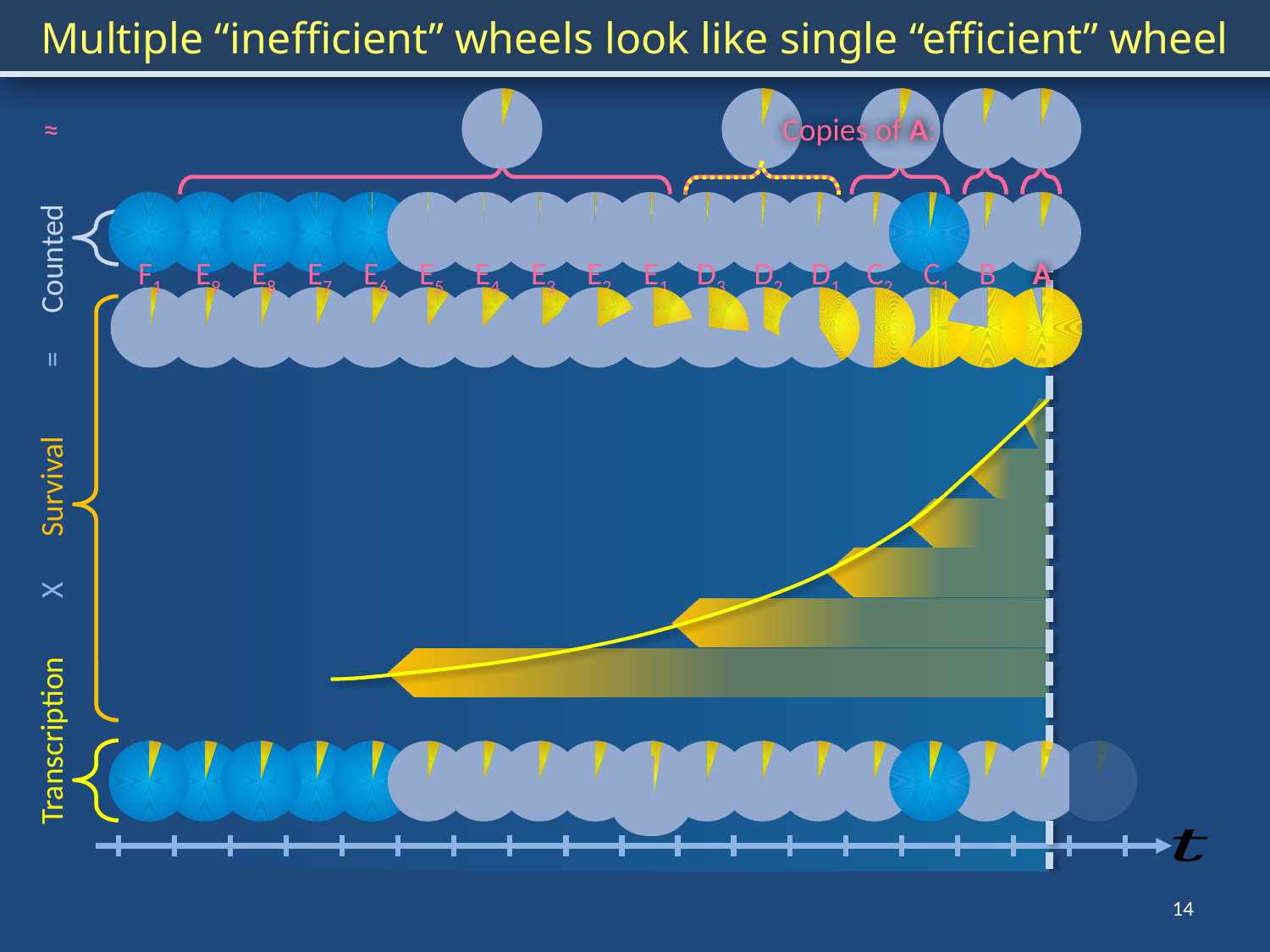
Does the yellow survival curve rise or fall as t increases along the horizontal axis? rise What is the label of the horizontal axis at the bottom of the diagram? t How many labelled wheels (F1 through A) are shown in the Counted row? 17 What is the title of the slide? Multiple "inefficient" wheels look like single "efficient" wheel